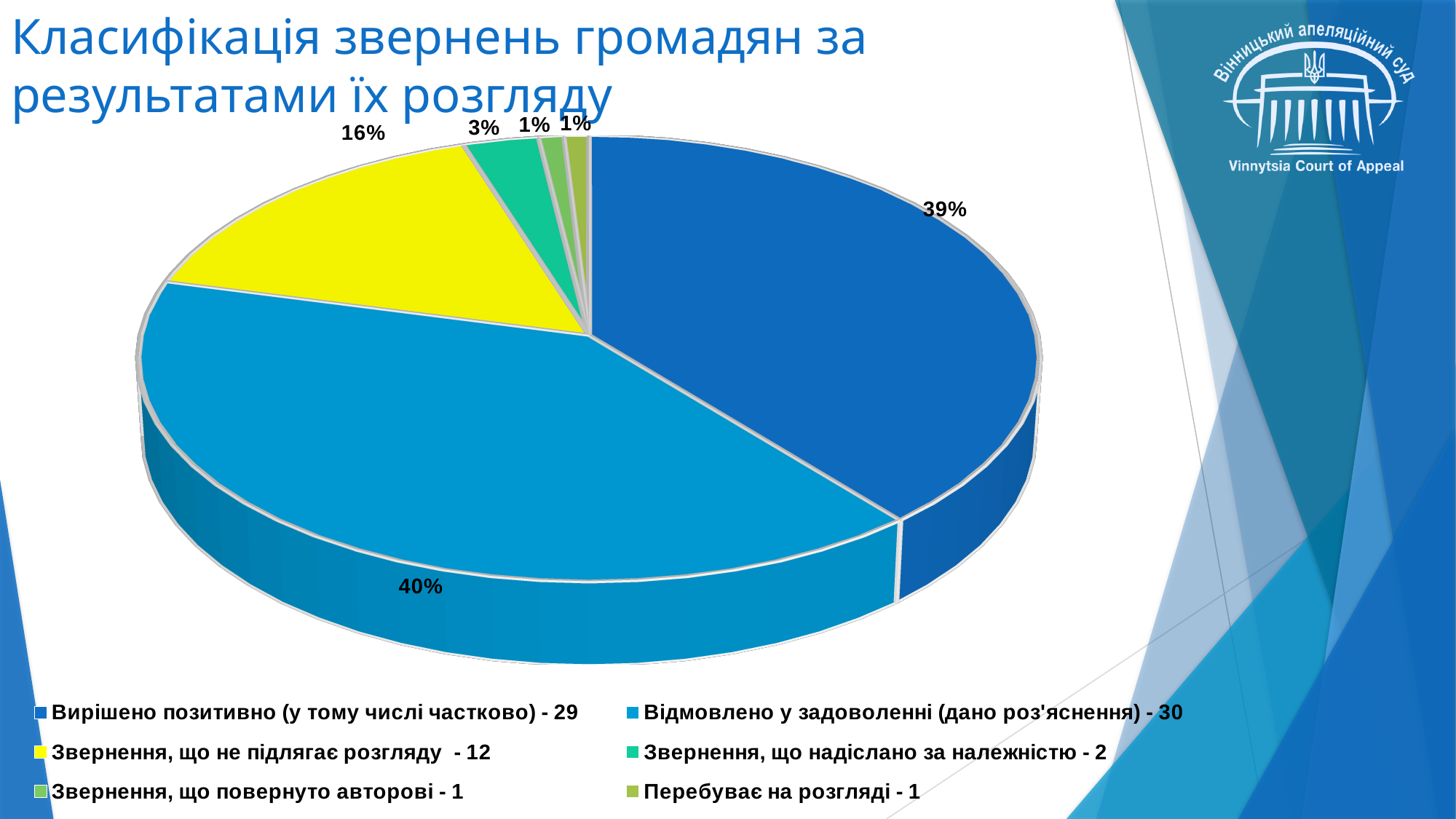
What is the difference in percentage points between the "Відмовлено у задоволенні" slice and the "Вирішено позитивно" slice? 1% How many categories does the pie chart have? 6 Which is larger: the share for "Звернення, що не підлягає розгляду" or the share for "Звернення, що надіслано за належністю"? Звернення, що не підлягає розгляду What kind of chart is shown on the slide? pie chart What share of the pie does "Відмовлено у задоволенні (дано роз'яснення)" represent? 40% What colour is the slice for "Звернення, що не підлягає розгляду"? yellow What share of the pie does "Звернення, що надіслано за належністю" represent? 3% Which category has the largest share of the pie? Відмовлено у задоволенні (дано роз'яснення) What share of the pie does "Звернення, що не підлягає розгляду" represent? 16% How many appeals are listed in the legend for "Звернення, що не підлягає розгляду"? 12 How many appeals are listed in the legend for "Відмовлено у задоволенні (дано роз'яснення)"? 30